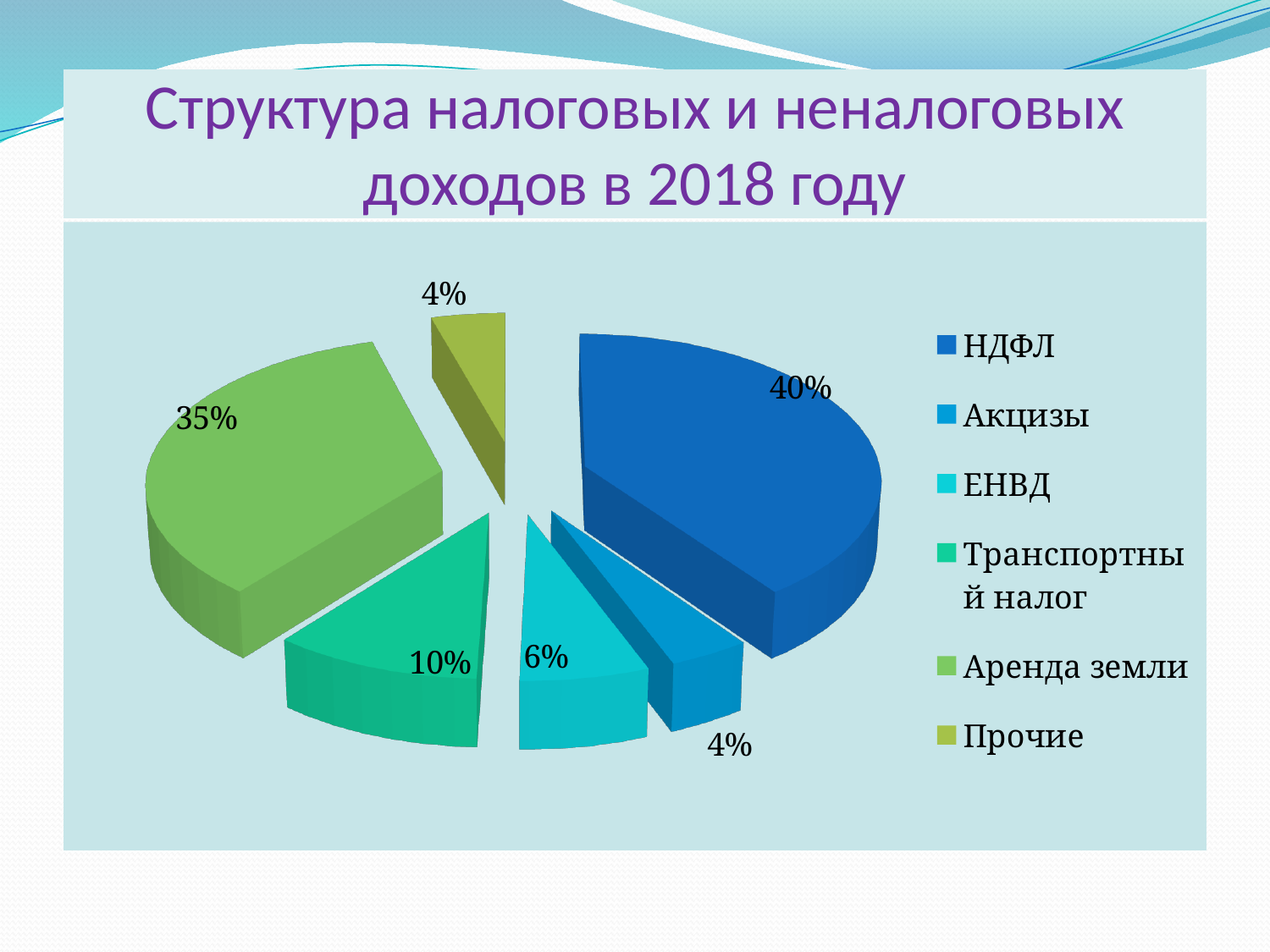
Which is larger, the share of Транспортный налог or the share of ЕНВД? Транспортный налог What is the difference between the shares of НДФЛ and Аренда земли? 5% What share of the pie does Аренда земли have? 35% What is the value for ЕНВД? 6% What share of the pie does НДФЛ have? 40% What is the title of the chart? Структура налоговых и неналоговых доходов в 2018 году How many categories does the legend list? 6 Which category has the largest slice of the pie? НДФЛ What kind of chart is shown on the slide? pie chart What is the value for Транспортный налог? 10% Which legend entry is shown in dark blue? НДФЛ What is the value for Акцизы? 4%